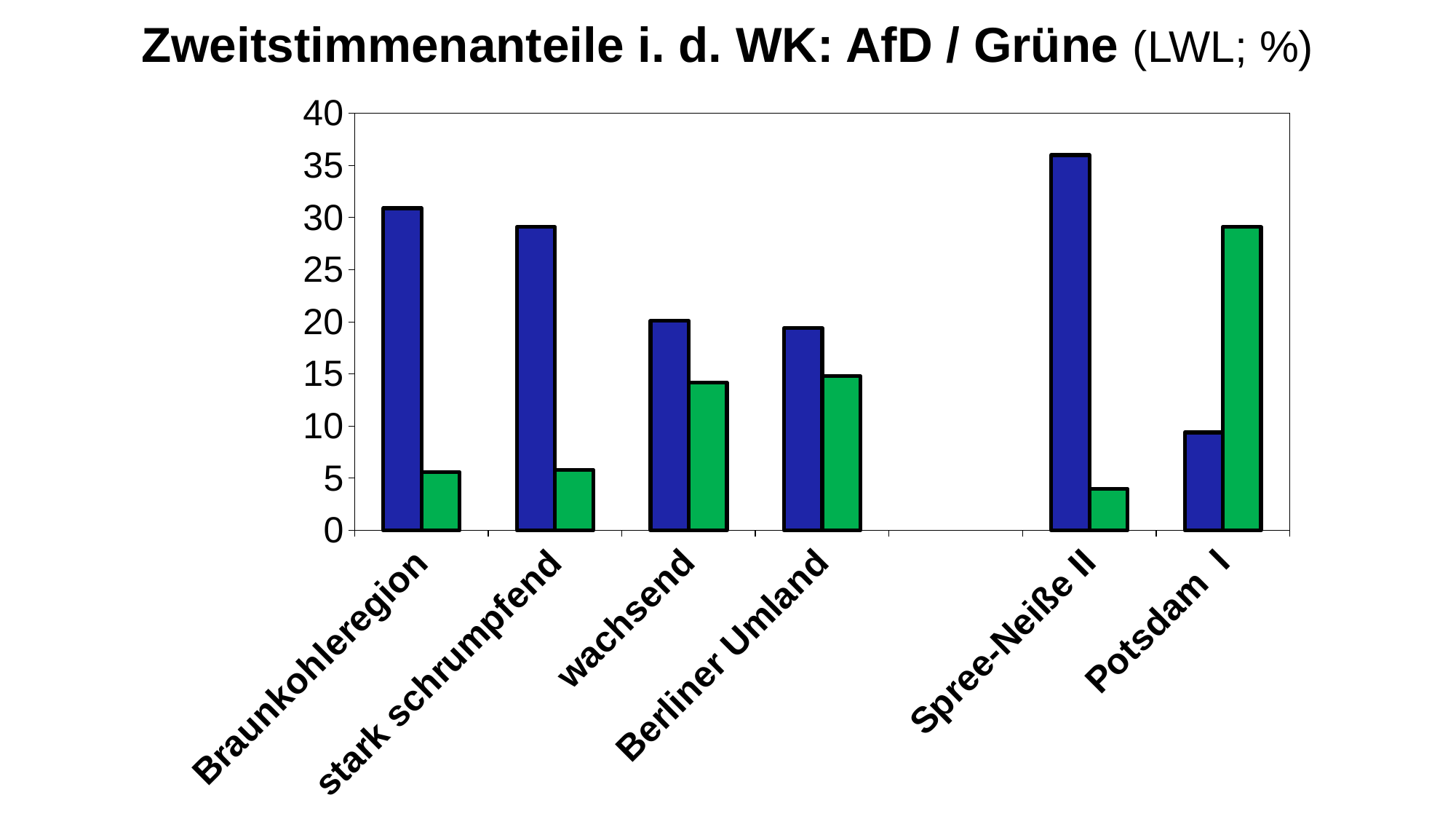
Is the green bar for Berliner Umland greater or less than 20? less What is the title of the chart? Zweitstimmenanteile i. d. WK: AfD / Grüne (LWL; %) For Braunkohleregion, which bar is taller, the blue one or the green one? blue Is the blue bar for Spree-Neiße II greater or less than 30? greater Is the green bar for Potsdam I greater or less than 25? greater Which category has the tallest blue bar? Spree-Neiße II Which category has the shortest green bar? Spree-Neiße II Which category has the tallest green bar? Potsdam I Which category has the shortest blue bar? Potsdam I For Potsdam I, which bar is taller, the blue one or the green one? green How many labelled categories are shown on the x axis? 6 What kind of chart is shown on the slide? bar chart